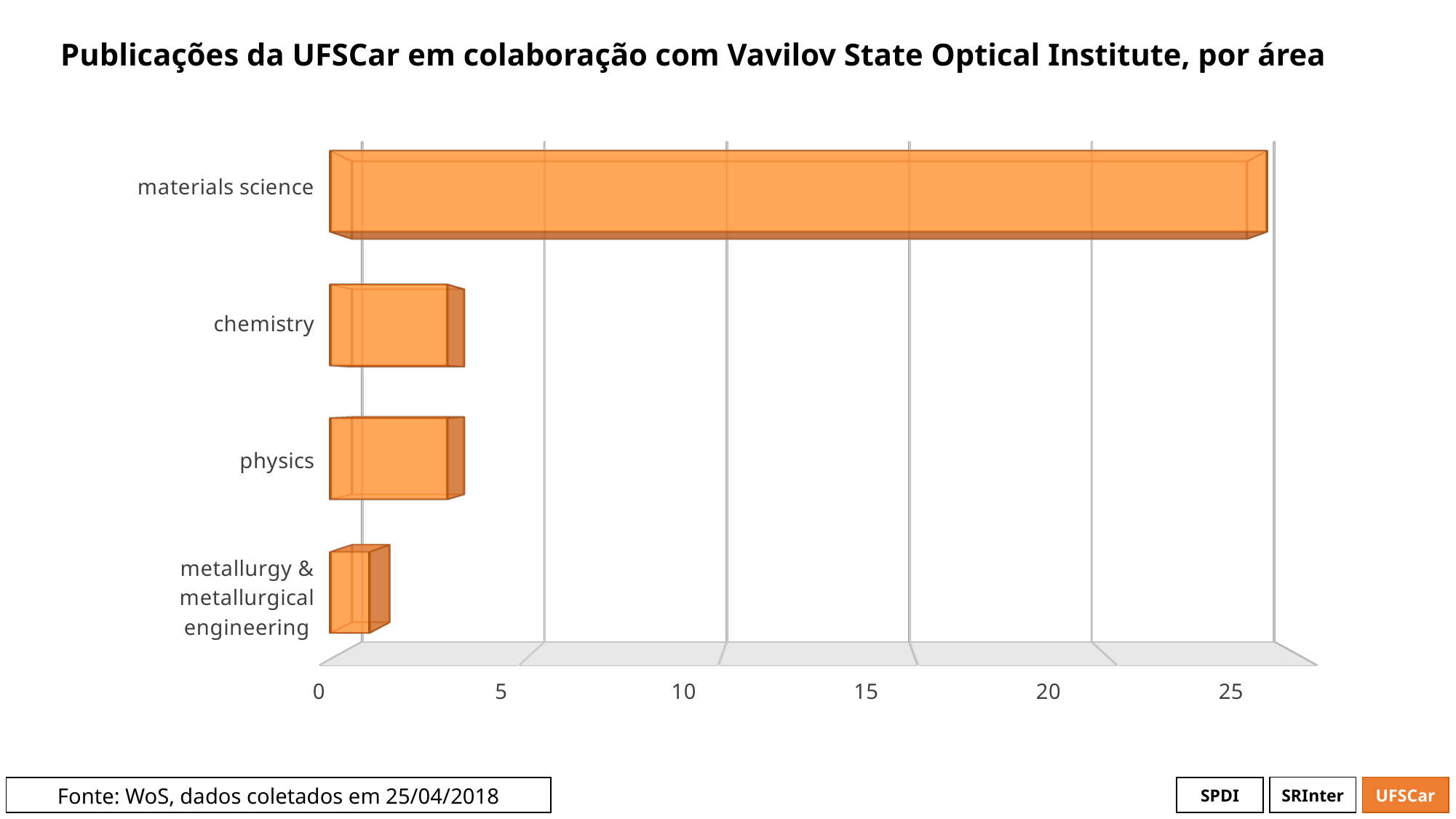
How many areas (categories) are shown in the chart? 4 Which area has the lowest number of publications? metallurgy & metallurgical engineering Which has more publications, materials science or chemistry? materials science Which has more publications, physics or metallurgy & metallurgical engineering? physics Is the value for physics greater or less than 5? less What is the highest value labelled on the horizontal axis? 25 Is the value for chemistry greater or less than 5? less Is the value for metallurgy & metallurgical engineering greater or less than 5? less What kind of chart is shown on the slide? bar chart What is the title of the chart? Publicações da UFSCar em colaboração com Vavilov State Optical Institute, por área Which area has the highest number of publications? materials science